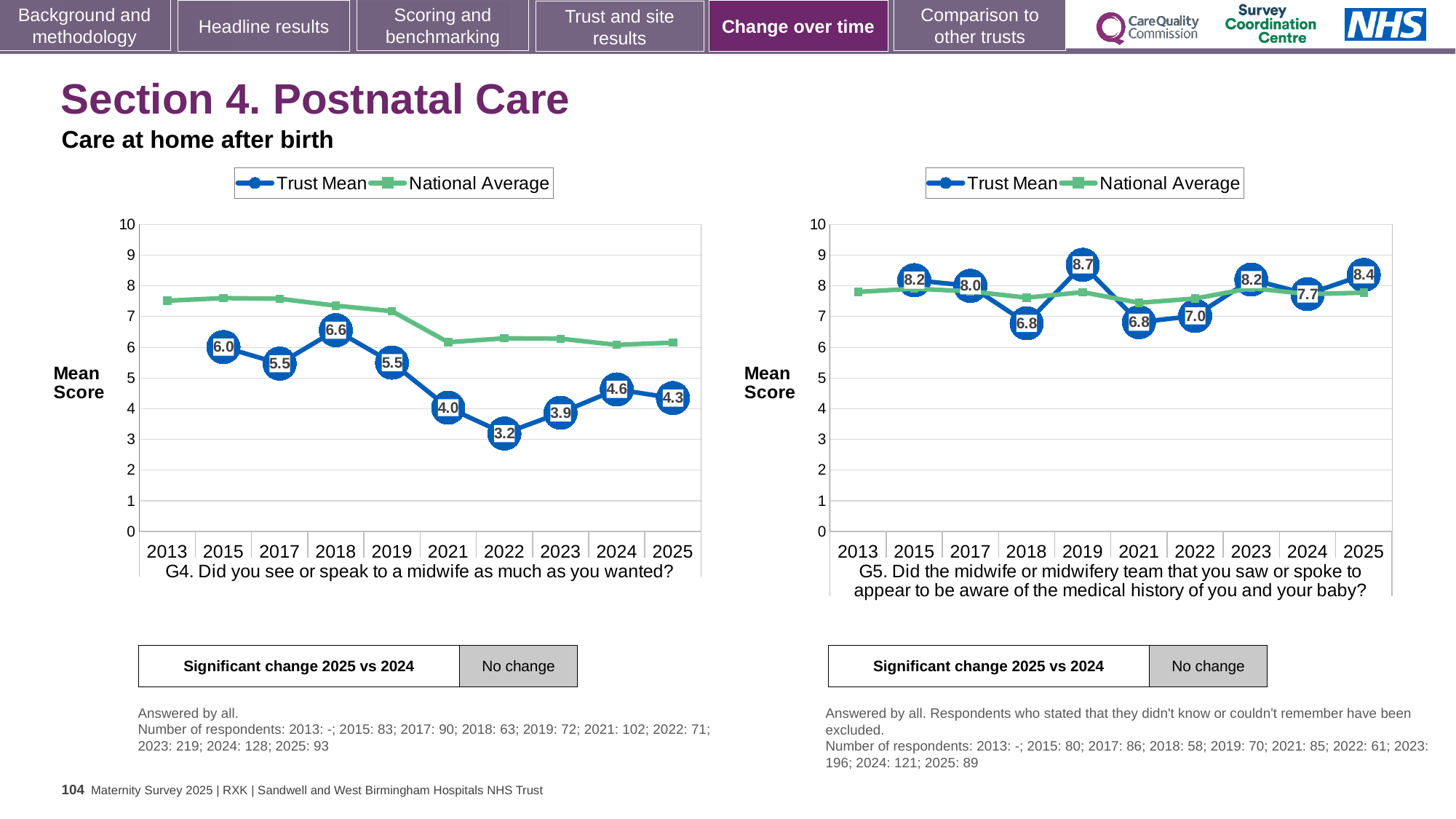
In the G5 chart (right), what is the difference between the Trust Mean scores for 2025 and 2024? 0.7 In the G4 chart (left), is the National Average for 2015 greater or less than 7? greater In the G4 chart (left), what is the Trust Mean score for 2022? 3.2 In the G4 chart (left), which year has the highest Trust Mean score? 2018 In the G4 chart (left), what is the difference between the Trust Mean scores for 2024 and 2025? 0.3 In the G5 chart (right), which year has the highest Trust Mean score? 2019 In the G5 chart (right), is the Trust Mean score for 2023 larger or smaller than the score for 2024? larger What kind of chart is the G5 chart (right)? Line chart How many series does the legend of the G4 chart (left) list? 2 In the G4 chart (left), which year has the lowest Trust Mean score? 2022 In the G5 chart (right), what is the Trust Mean score for 2019? 8.7 In the G4 chart (left), what is the Trust Mean score for 2025? 4.3